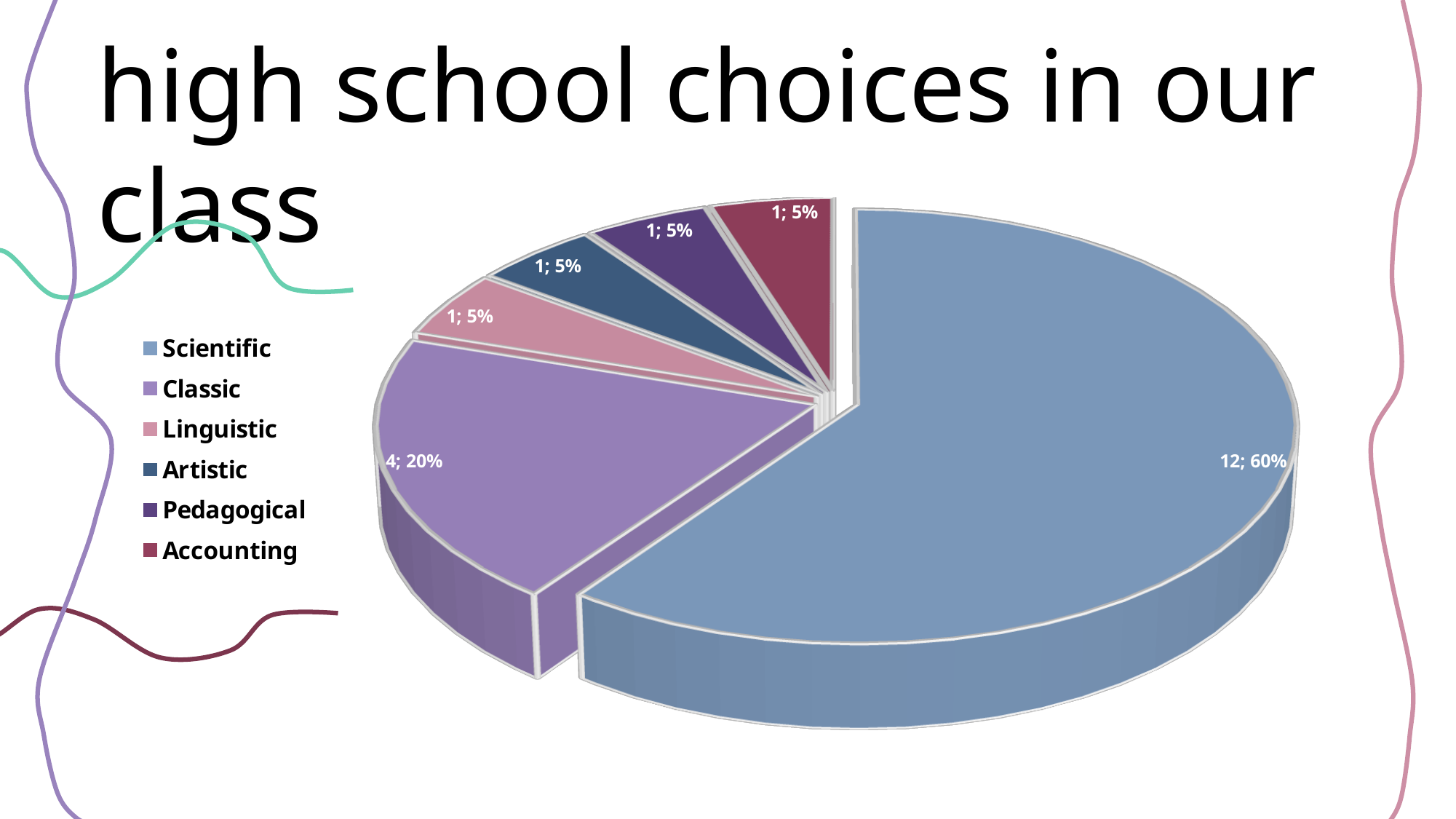
What share of the pie does Scientific take? 60% Which category has the largest slice? Scientific What is the value for Scientific? 12 What is the value for Classic? 4 What kind of chart is shown on the slide? pie chart What is the value for Accounting? 1 What share of the pie does Linguistic take? 5% What share of the pie does Classic take? 20% How many categories does the pie chart have? 6 Which legend entry is listed first? Scientific Which is larger, the value for Classic or the value for Artistic? Classic What is the difference between the values for Scientific and Classic? 8